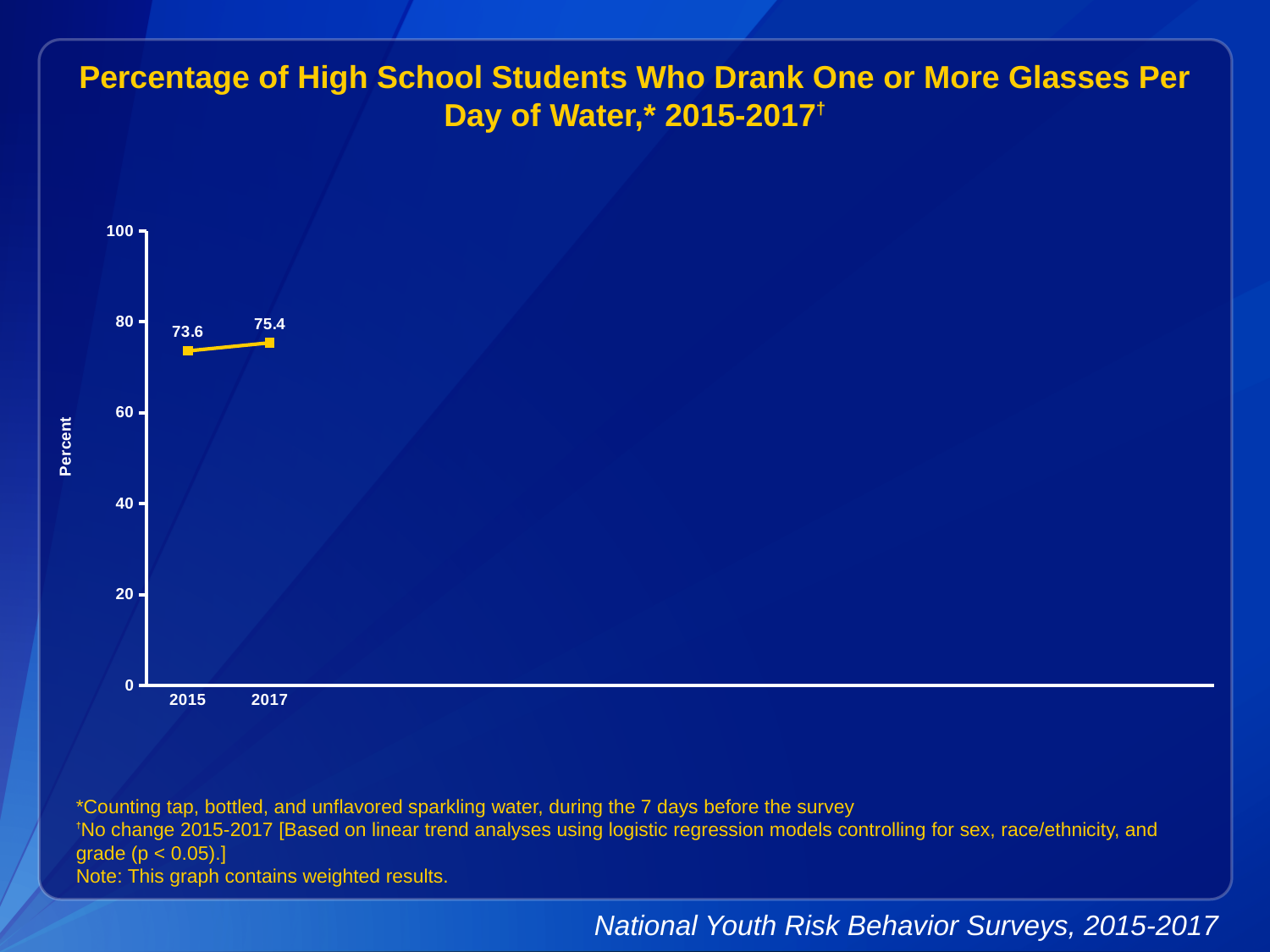
What is the value for 2015? 73.6 Is the value for 2015 greater or less than 80? less Which year has the higher value? 2017 How many data points are plotted on the chart? 2 Is the value for 2017 greater or less than 60? greater What kind of chart is shown on the slide? line chart What is the maximum value shown on the y axis? 100 What is the label on the y axis? Percent What is the difference between the 2017 and 2015 values? 1.8 Do the values rise or fall from 2015 to 2017? rise What is the value for 2017? 75.4 Which year has the lower value? 2015